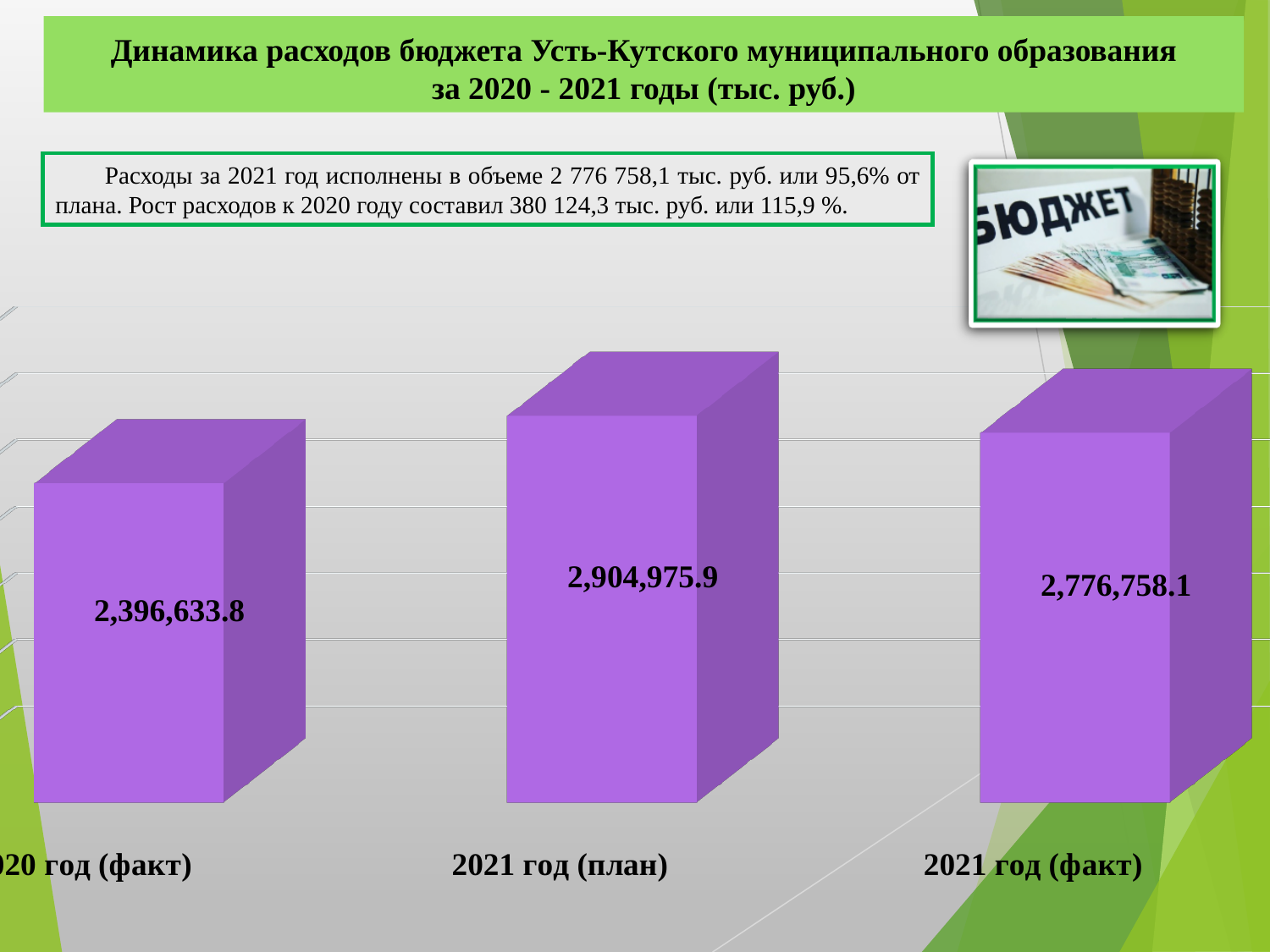
What type of chart is shown on the slide? Bar chart What is the value for 2021 год (план)? 2,904,975.9 What is the difference between 2021 год (план) and 2021 год (факт)? 128,217.8 What is the value for 2020 год (факт)? 2,396,633.8 What is the value for 2021 год (факт)? 2,776,758.1 How many bars (categories) does the chart show? 3 Which is larger, the value for 2020 год (факт) or 2021 год (факт)? 2021 год (факт) Which is larger, the value for 2021 год (план) or 2021 год (факт)? 2021 год (план) Which category has the lowest value? 2020 год (факт) What is the title of the slide containing the chart? Динамика расходов бюджета Усть-Кутского муниципального образования за 2020 - 2021 годы (тыс. руб.) What is the difference between 2021 год (факт) and 2020 год (факт)? 380,124.3 Which category has the highest value? 2021 год (план)